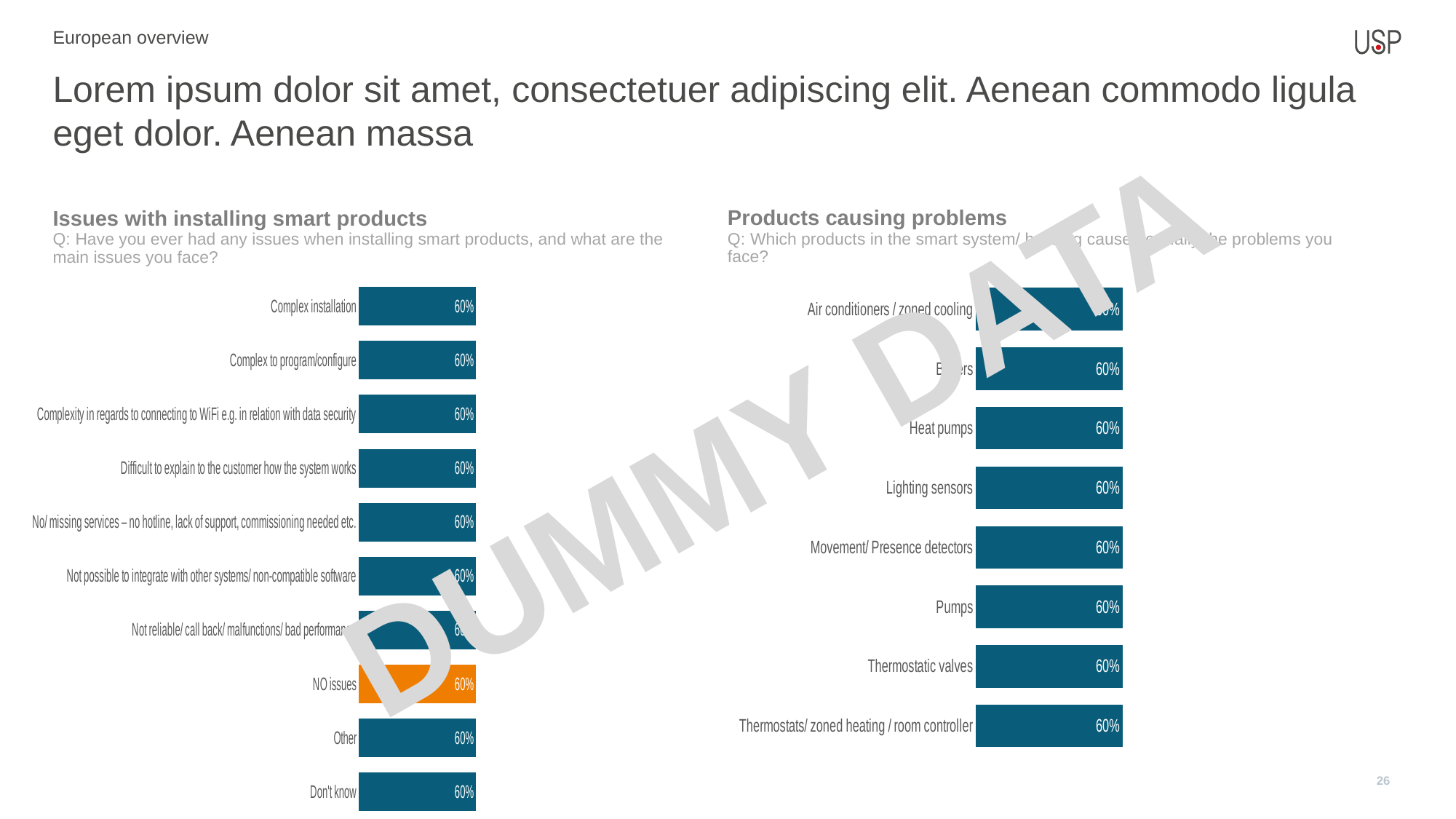
In the 'Issues with installing smart products' chart, what is the value for Complex installation? 60% In the 'Products causing problems' chart, what is the value for Heat pumps? 60% In the 'Issues with installing smart products' chart, what is the value for NO issues? 60% How many categories are shown in the 'Products causing problems' chart? 8 In the 'Issues with installing smart products' chart, what is the difference between the values for Complex installation and Other? 0% In the 'Issues with installing smart products' chart, which category's bar is coloured orange? NO issues In the 'Products causing problems' chart, what is the value for Pumps? 60% What kind of chart is the 'Products causing problems' chart? Bar chart In the 'Issues with installing smart products' chart, what is the value for Don't know? 60% In the 'Products causing problems' chart, what is the value for Thermostats/ zoned heating / room controller? 60% How many categories are shown in the 'Issues with installing smart products' chart? 10 What is the title of the chart on the right side of the slide? Products causing problems